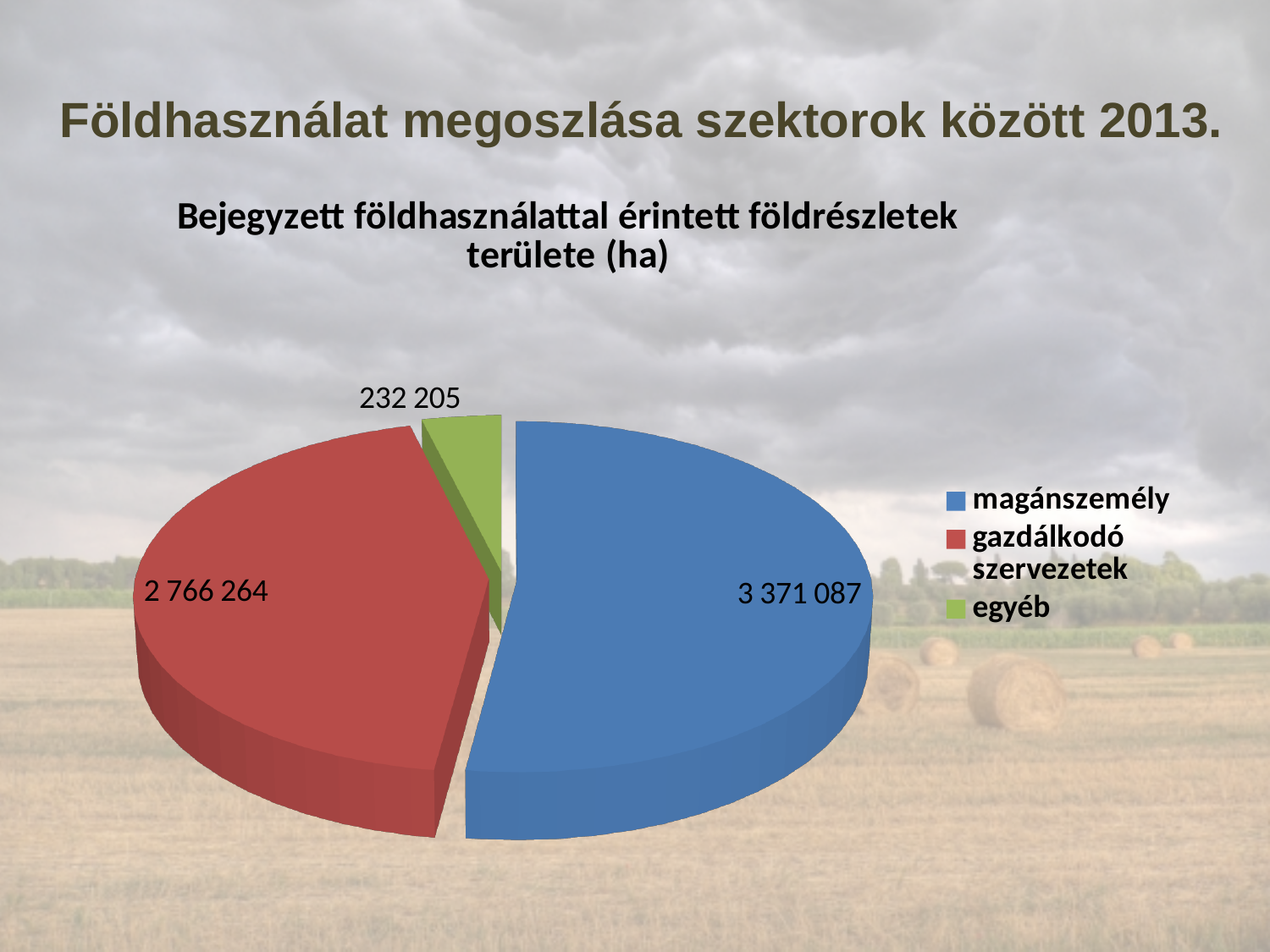
What type of chart is shown on the slide? pie chart Which category has the smallest slice of the pie? egyéb Which category has the largest slice of the pie? magánszemély How many categories does the pie chart show? 3 What is the total of all slices in the pie chart? 6 369 556 What is the value for gazdálkodó szervezetek? 2 766 264 Which is larger, the value for magánszemély or the value for gazdálkodó szervezetek? magánszemély What is the title of the chart? Bejegyzett földhasználattal érintett földrészletek területe (ha) What is the value for magánszemély? 3 371 087 What is the difference between the values for magánszemély and gazdálkodó szervezetek? 604 823 What is the difference between the values for gazdálkodó szervezetek and egyéb? 2 534 059 What is the value for egyéb? 232 205